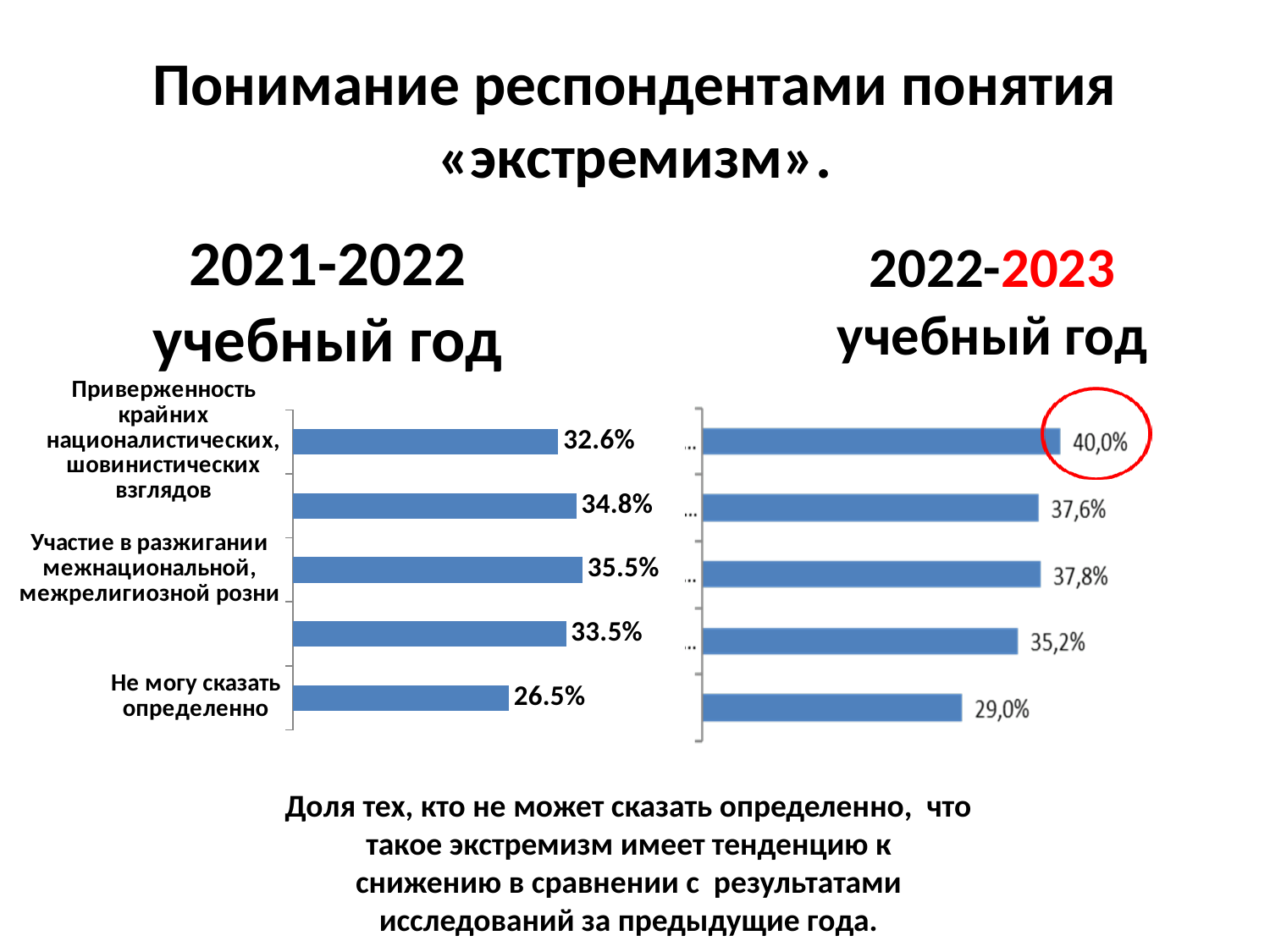
In the 2021-2022 учебный год chart, which labelled category has the lowest value? Не могу сказать определенно In the 2022-2023 учебный год chart, what is the value of the top bar? 40,0% In the 2021-2022 учебный год chart, which is larger: the value for «Участие в разжигании межнациональной, межрелигиозной розни» or for «Приверженность крайних националистических, шовинистических взглядов»? Участие в разжигании межнациональной, межрелигиозной розни What type of chart is the 2021-2022 учебный год chart? Bar chart In the 2021-2022 учебный год chart, what is the value for «Участие в разжигании межнациональной, межрелигиозной розни»? 35.5% In the 2022-2023 учебный год chart, what is the value of the bottom bar? 29,0% In the 2021-2022 учебный год chart, what is the value for «Не могу сказать определенно»? 26.5% In the 2021-2022 учебный год chart, which labelled category has the highest value? Участие в разжигании межнациональной, межрелигиозной розни How many bars does the 2022-2023 учебный год chart have? 5 In the 2021-2022 учебный год chart, what is the value for «Приверженность крайних националистических, шовинистических взглядов»? 32.6% In the 2021-2022 учебный год chart, what is the difference between the value for «Участие в разжигании межнациональной, межрелигиозной розни» and the value for «Не могу сказать определенно»? 9.0% In the 2022-2023 учебный год chart, what is the lowest value shown? 29,0%